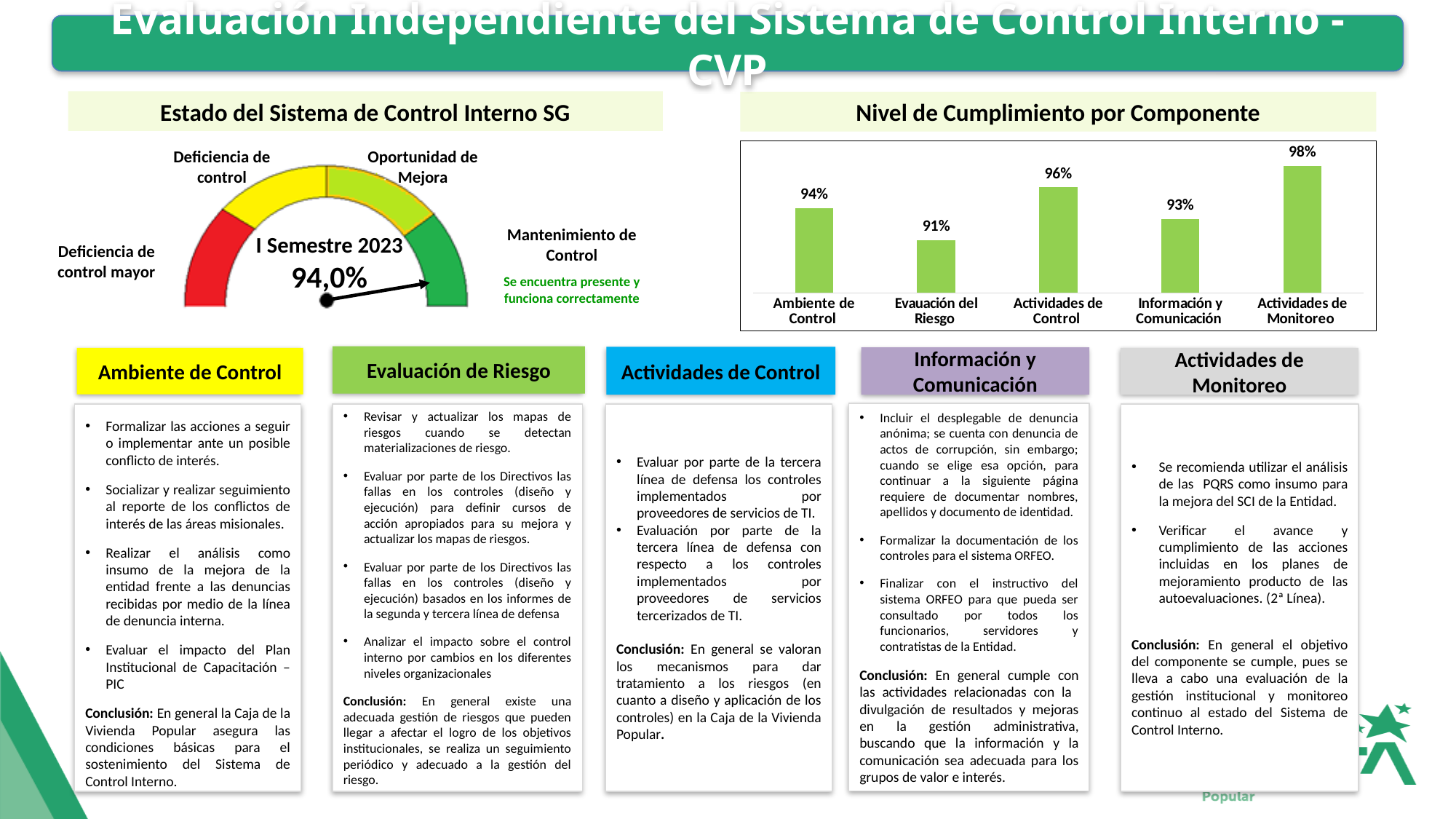
How many components are shown in the 'Nivel de Cumplimiento por Componente' chart? 5 What kind of chart is 'Nivel de Cumplimiento por Componente'? Bar chart In the 'Nivel de Cumplimiento por Componente' chart, which component has the lowest value? Evauación del Riesgo In the gauge chart on the left, which zone does the needle point to? Mantenimiento de Control In the gauge chart under 'Estado del Sistema de Control Interno SG', what value is shown for I Semestre 2023? 94,0% What colour are the bars in the 'Nivel de Cumplimiento por Componente' chart? Green In the 'Nivel de Cumplimiento por Componente' chart, what is the difference between Actividades de Monitoreo and Evauación del Riesgo? 7% In the 'Nivel de Cumplimiento por Componente' chart, what is the value for Actividades de Monitoreo? 98% In the 'Nivel de Cumplimiento por Componente' chart, which is larger: Actividades de Control or Información y Comunicación? Actividades de Control In the 'Nivel de Cumplimiento por Componente' chart, which component has the highest value? Actividades de Monitoreo In the 'Nivel de Cumplimiento por Componente' chart, what is the value for Información y Comunicación? 93% In the 'Nivel de Cumplimiento por Componente' chart, what is the value for Ambiente de Control? 94%